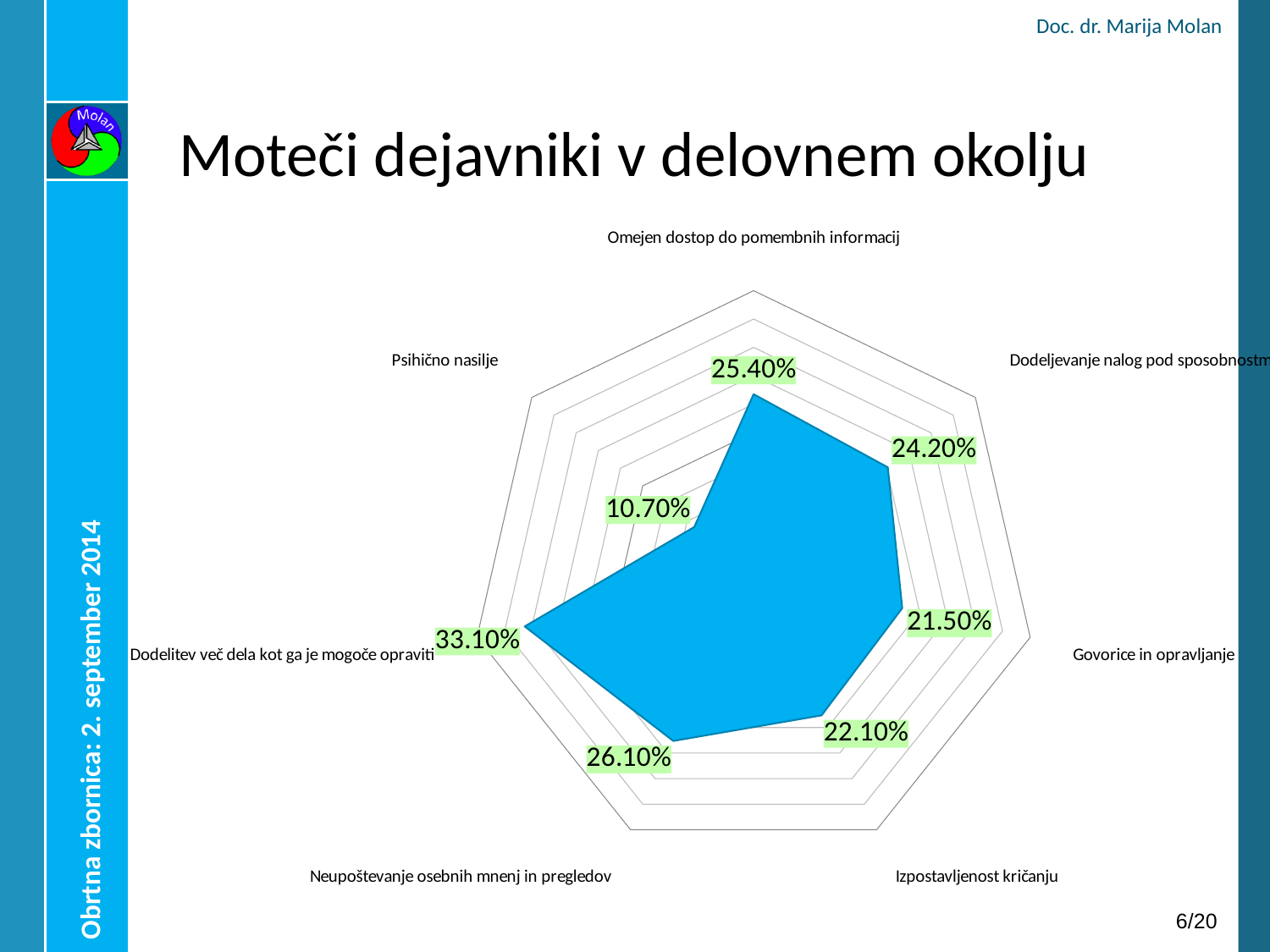
What is the value for Psihično nasilje? 10.70% What is the difference between the values for Dodelitev več dela kot ga je mogoče opraviti and Psihično nasilje? 22.40% Which is larger, the value for Neupoštevanje osebnih mnenj in pregledov or the value for Govorice in opravljanje? Neupoštevanje osebnih mnenj in pregledov Which category has the lowest value? Psihično nasilje What is the value for Govorice in opravljanje? 21.50% What is the value for Izpostavljenost kričanju? 22.10% What is the value for Omejen dostop do pomembnih informacij? 25.40% What type of chart is shown on the slide? Radar chart Which category has the highest value? Dodelitev več dela kot ga je mogoče opraviti What is the value for Neupoštevanje osebnih mnenj in pregledov? 26.10% How many categories does the radar chart have? 7 What is the value for Dodelitev več dela kot ga je mogoče opraviti? 33.10%